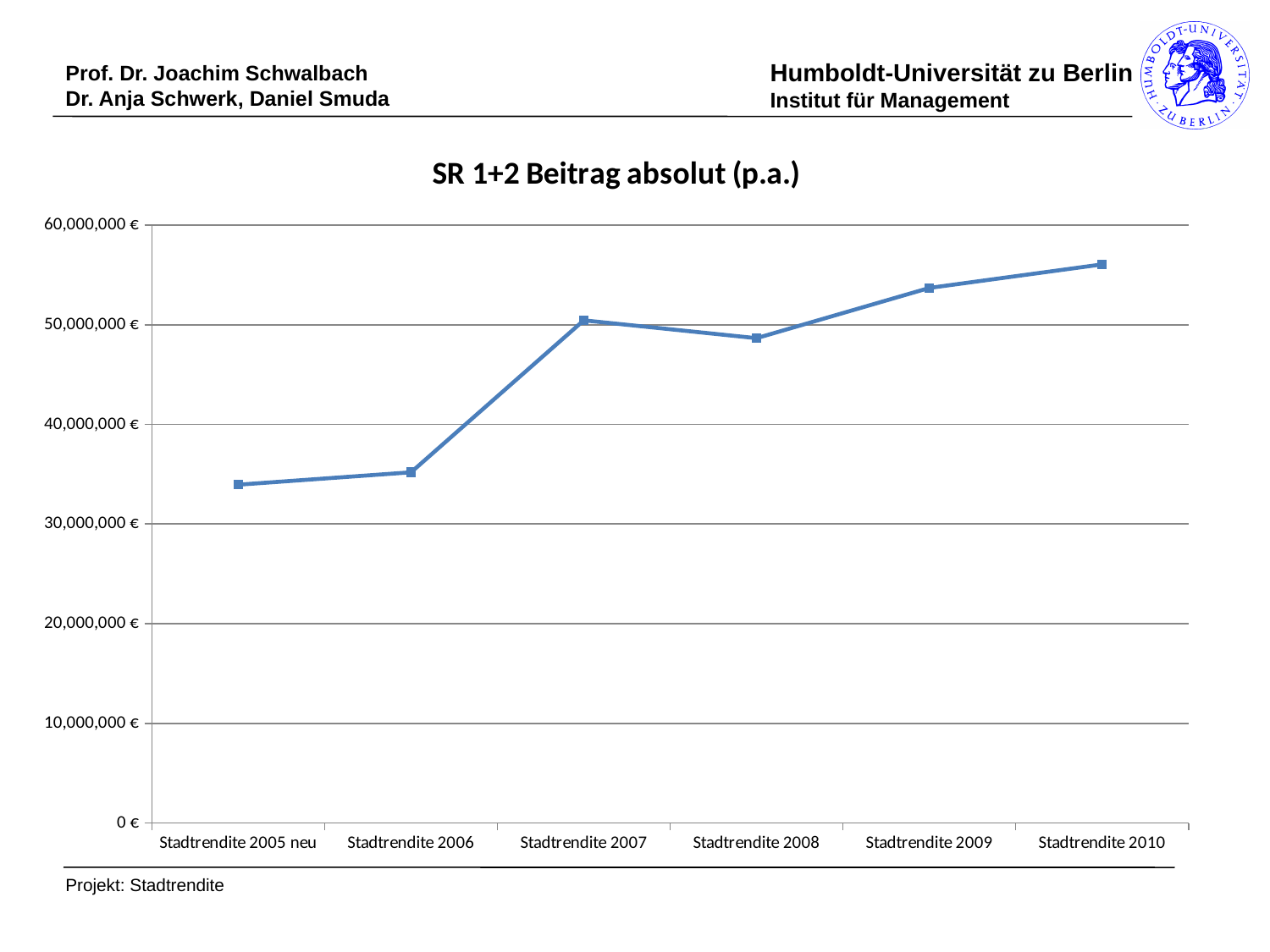
How many data points are plotted on the chart? 6 What is the title of the chart? SR 1+2 Beitrag absolut (p.a.) Which category has the lowest value? Stadtrendite 2005 neu Which category has the highest value? Stadtrendite 2010 Is the value for Stadtrendite 2006 greater or less than 40,000,000 €? less Is the value for Stadtrendite 2008 greater or less than 50,000,000 €? less What kind of chart is shown on the slide? line chart Which is larger, the value for Stadtrendite 2009 or Stadtrendite 2006? Stadtrendite 2009 Is the value for Stadtrendite 2005 neu greater or less than 30,000,000 €? greater Between Stadtrendite 2008 and Stadtrendite 2010, do the values rise or fall? rise Which is larger, the value for Stadtrendite 2007 or Stadtrendite 2008? Stadtrendite 2007